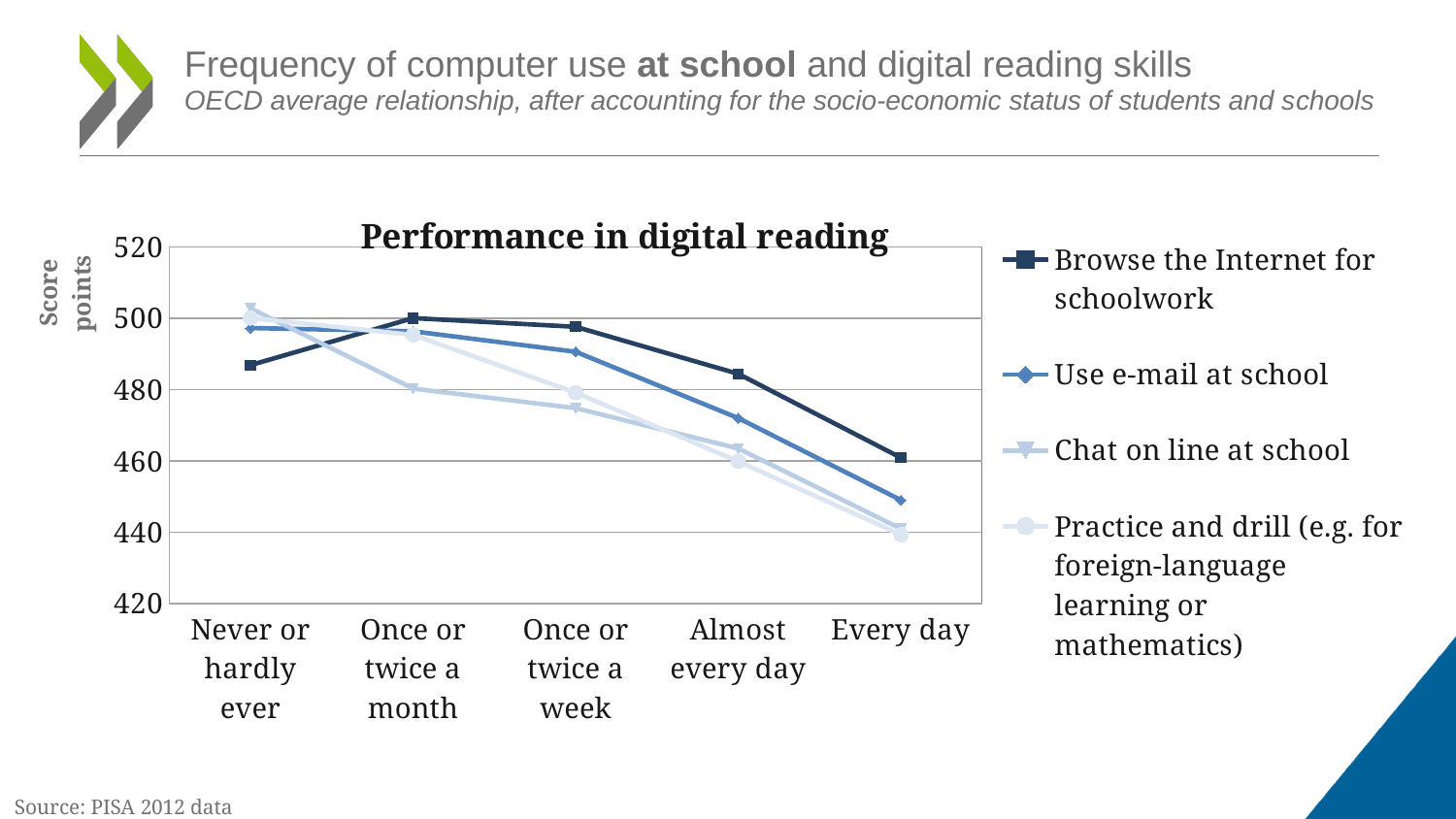
What kind of chart is shown on the slide? line chart What is the title of the chart? Performance in digital reading How many series does the legend list? 4 Is the value for "Use e-mail at school" at "Every day" greater or less than 460? less Which series has the highest value at "Every day"? Browse the Internet for schoolwork How many frequency categories are shown along the x axis? 5 What is the label on the vertical axis? Score points Do the values for "Use e-mail at school" rise or fall from "Never or hardly ever" to "Every day"? fall For "Browse the Internet for schoolwork", which category has the lowest value? Every day For "Chat on line at school", which category has the lowest value? Every day At "Never or hardly ever", which is larger: "Chat on line at school" or "Browse the Internet for schoolwork"? Chat on line at school Is the value for "Browse the Internet for schoolwork" at "Never or hardly ever" greater or less than 480? greater